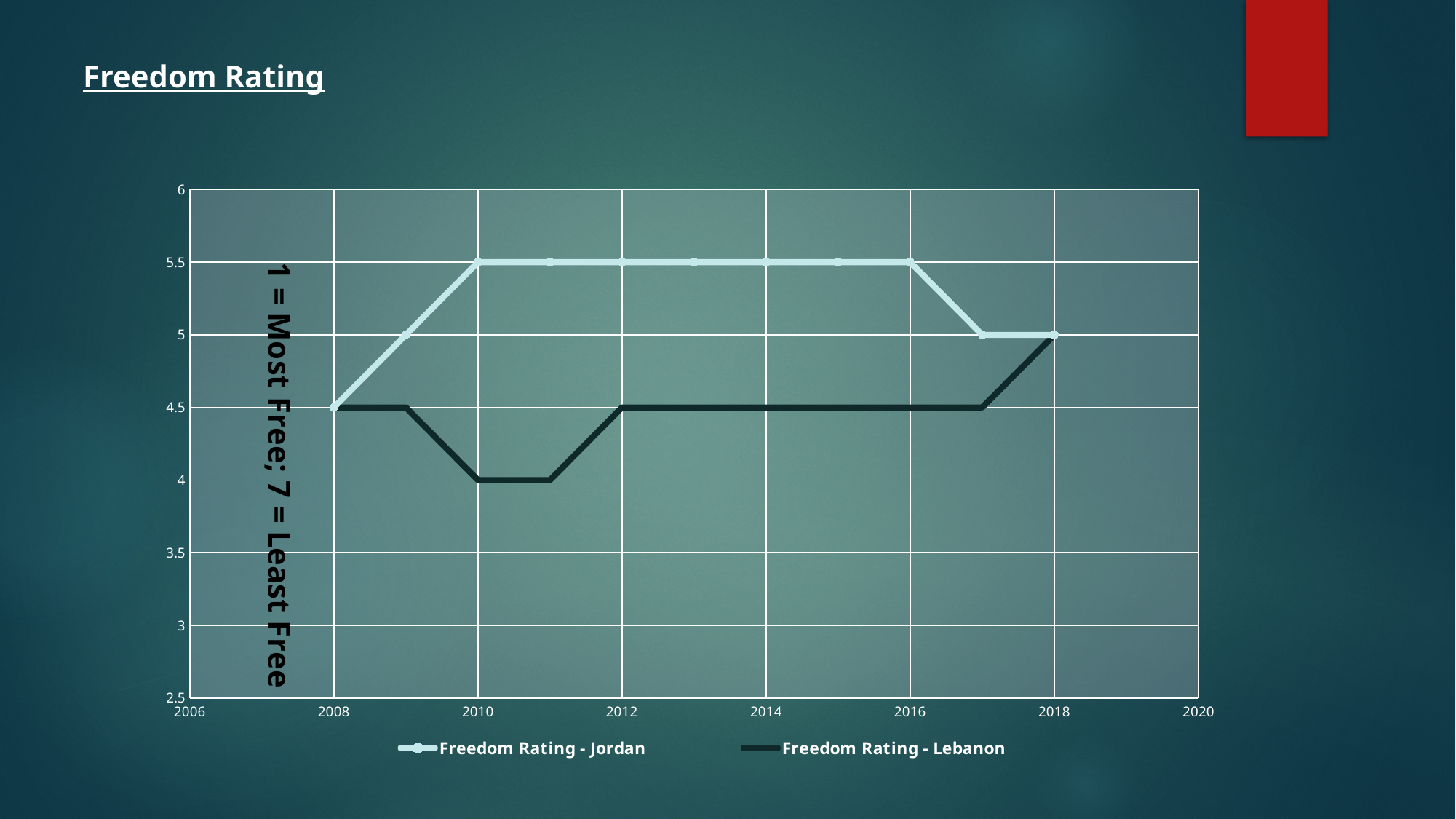
Which series has the higher value in 2011, Jordan or Lebanon? Jordan How many data points are plotted for the Jordan series? 11 How many series does the legend list? 2 What is the title of the slide? Freedom Rating What is the Freedom Rating for Jordan in 2012? 5.5 What is the Freedom Rating for Lebanon in 2018? 5 What kind of chart is shown on the slide? Line chart What is the difference between the Jordan and Lebanon Freedom Ratings in 2014? 1 In which year does the Lebanon series reach its highest value? 2018 What is the Freedom Rating for Lebanon in 2010? 4 Does the Jordan series rise or fall between 2016 and 2017? Fall What is the Freedom Rating for Jordan in 2008? 4.5